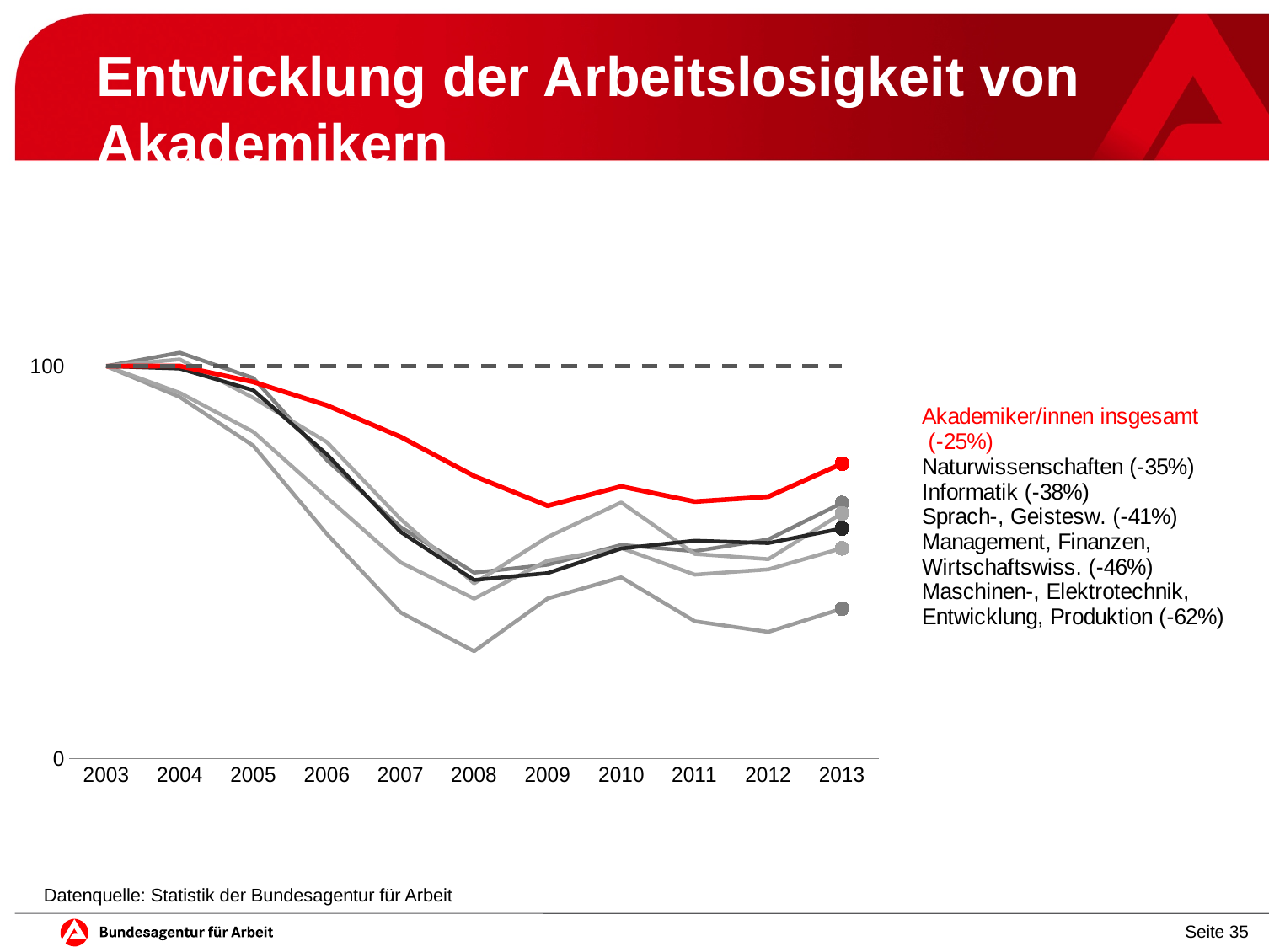
Which series is drawn in red on the chart? Akademiker/innen insgesamt How many series does the legend of the chart list? 6 What percentage change does the legend give for Sprach-, Geistesw.? -41% Which series in the legend shows the largest decline? Maschinen-, Elektrotechnik, Entwicklung, Produktion (-62%) What percentage change does the legend give for Informatik? -38% What kind of chart is shown on the slide? line chart Which series in the legend shows the smallest decline? Akademiker/innen insgesamt (-25%) Does the red line for Akademiker/innen insgesamt rise or fall overall from 2003 to 2013? fall Which series declined more according to the legend, Naturwissenschaften or Informatik? Informatik What percentage change does the legend give for Akademiker/innen insgesamt? -25% By how many percentage points does the decline for Maschinen-, Elektrotechnik, Entwicklung, Produktion exceed the decline for Akademiker/innen insgesamt? 37 percentage points How many years are shown on the x axis of the chart? 11